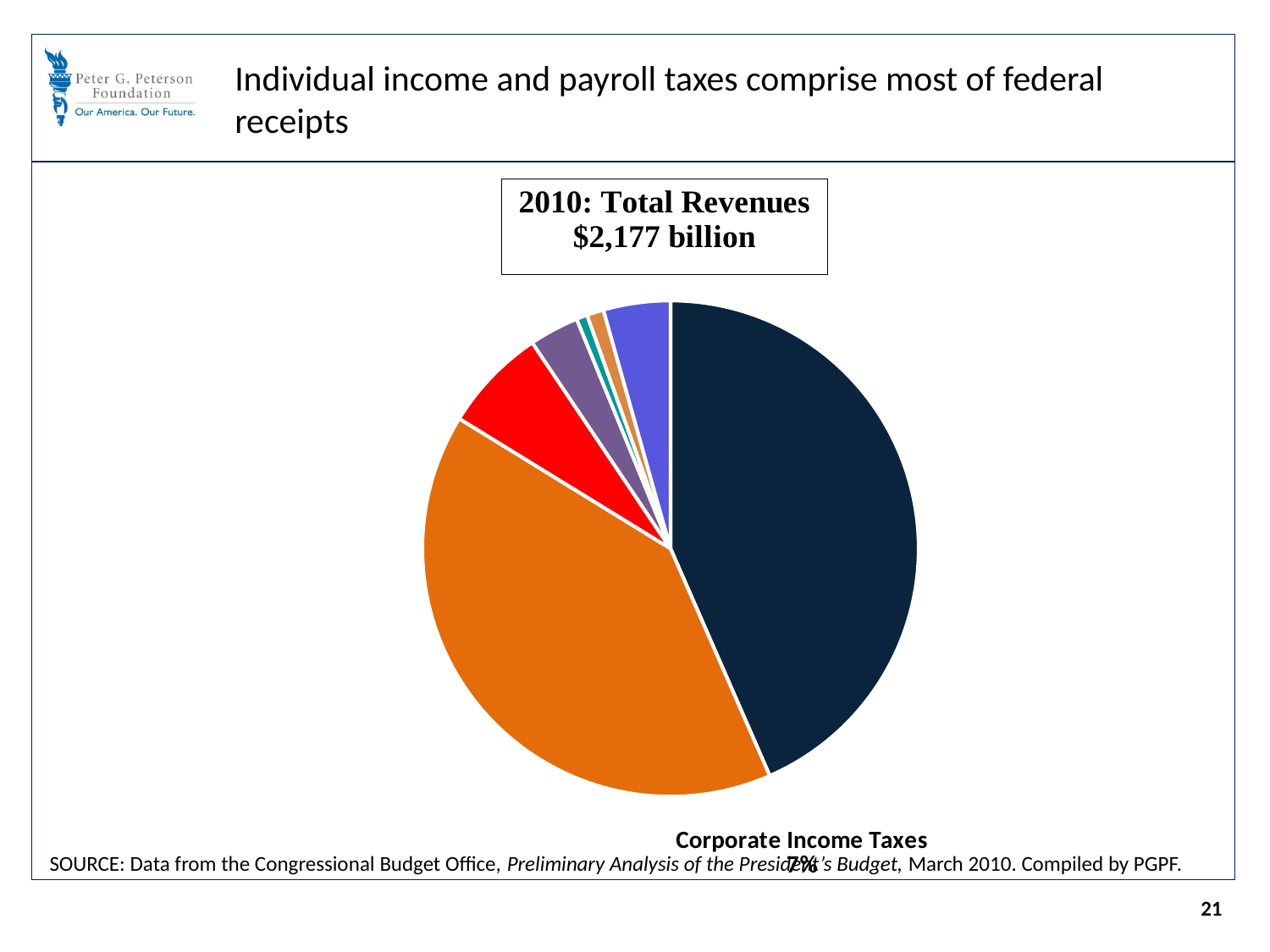
How many slices does the pie chart have? 7 What share of federal receipts do Corporate Income Taxes represent according to the data label? 7% What kind of chart is shown on the slide? pie chart What total revenue figure is shown in the box above the pie chart? $2,177 billion Which year do the total revenues in the pie chart refer to? 2010